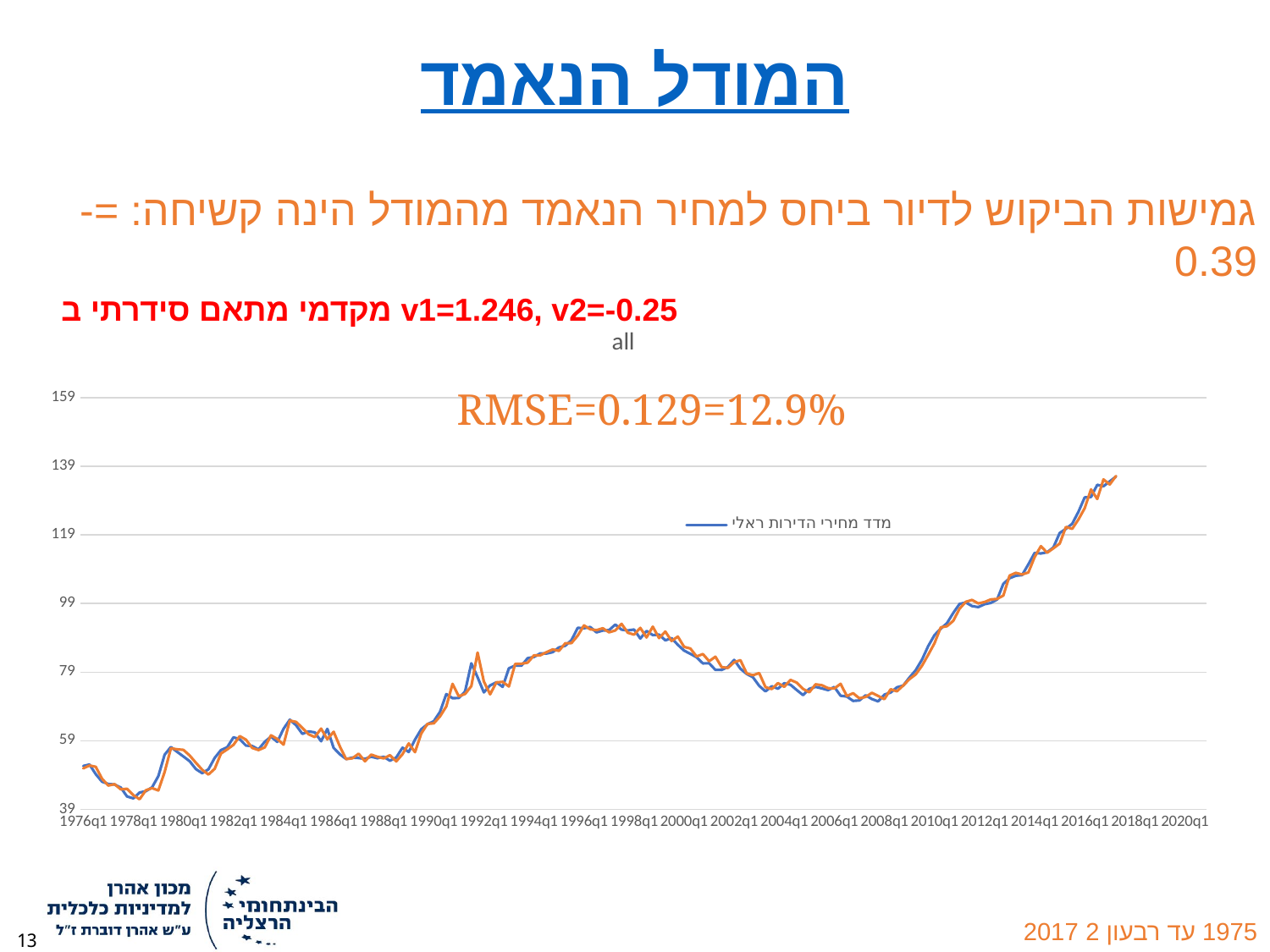
What kind of chart is shown on the slide? line chart Is the value of the index at 1996q1 greater or less than 79? greater Is the value of the index at 1978q1 greater or less than 59? less How many series does the chart legend list? 1 What is the title of the chart? all Is the value of the index at 2014q1 greater or less than 99? greater Does the index rise or fall overall between 1996q1 and 2008q1? fall What is the legend entry shown on the chart? מדד מחירי הדירות ראלי Around which year does the index reach its highest value? 2017